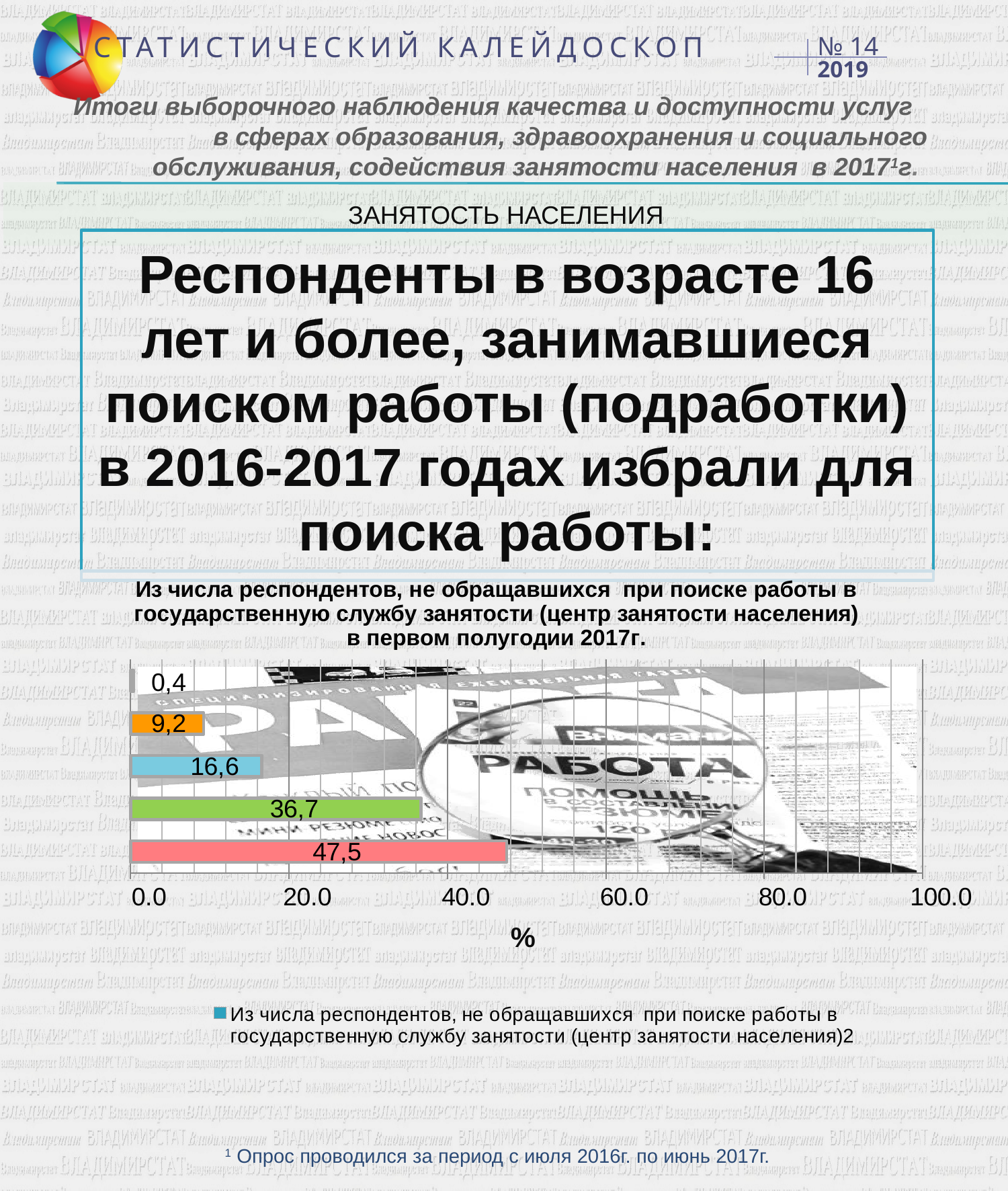
What is the largest value shown in the chart? 47,5 Is the value of the bottom (pink) bar greater or less than 40.0? greater What is the difference between the largest bar (47,5) and the green bar (36,7)? 10,8 What unit is shown under the horizontal axis of the chart? % How many bars are plotted in the chart? 5 Which is larger, the green bar or the orange bar? the green bar What is the smallest value shown in the chart? 0,4 What value is printed on the green bar? 36,7 What value is printed on the orange bar? 9,2 What value is printed on the bottom (pink) bar? 47,5 What value is printed on the light blue bar? 16,6 What kind of chart is shown on the slide? bar chart